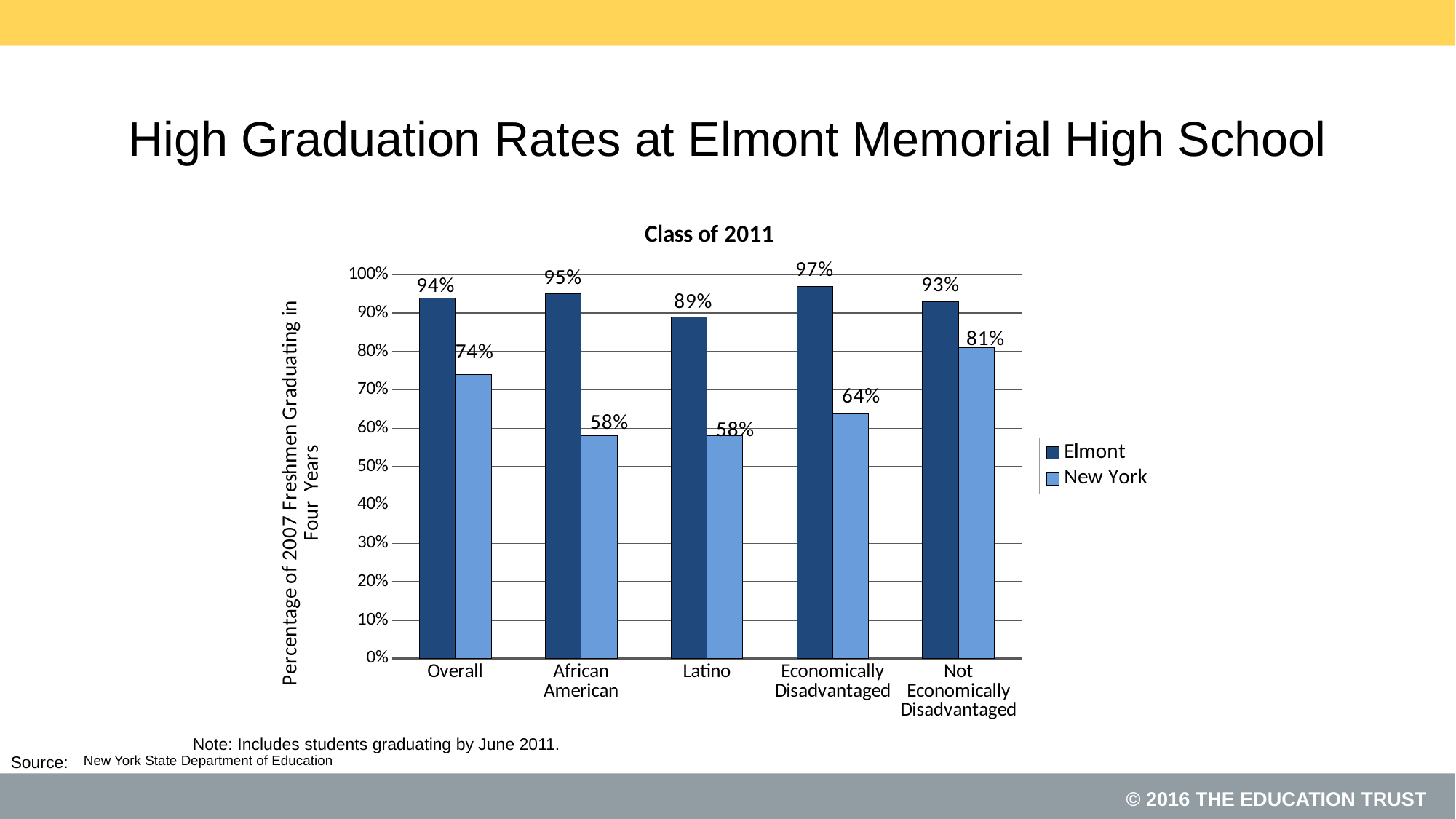
Which category has the highest New York graduation rate? Not Economically Disadvantaged Which category has the highest Elmont graduation rate? Economically Disadvantaged What is the Elmont graduation rate for Latino students? 89% What is the title of the chart? Class of 2011 How many categories are shown on the x axis? 5 What is the New York value for the Overall category? 74% What kind of chart is shown on the slide? Bar chart What is the New York graduation rate for Economically Disadvantaged students? 64% Which category has the lowest Elmont graduation rate? Latino Which is larger, the Elmont rate for Not Economically Disadvantaged students or the New York rate for Not Economically Disadvantaged students? Elmont What is the difference between the Elmont and New York rates for African American students? 37 percentage points How many series does the legend list? 2